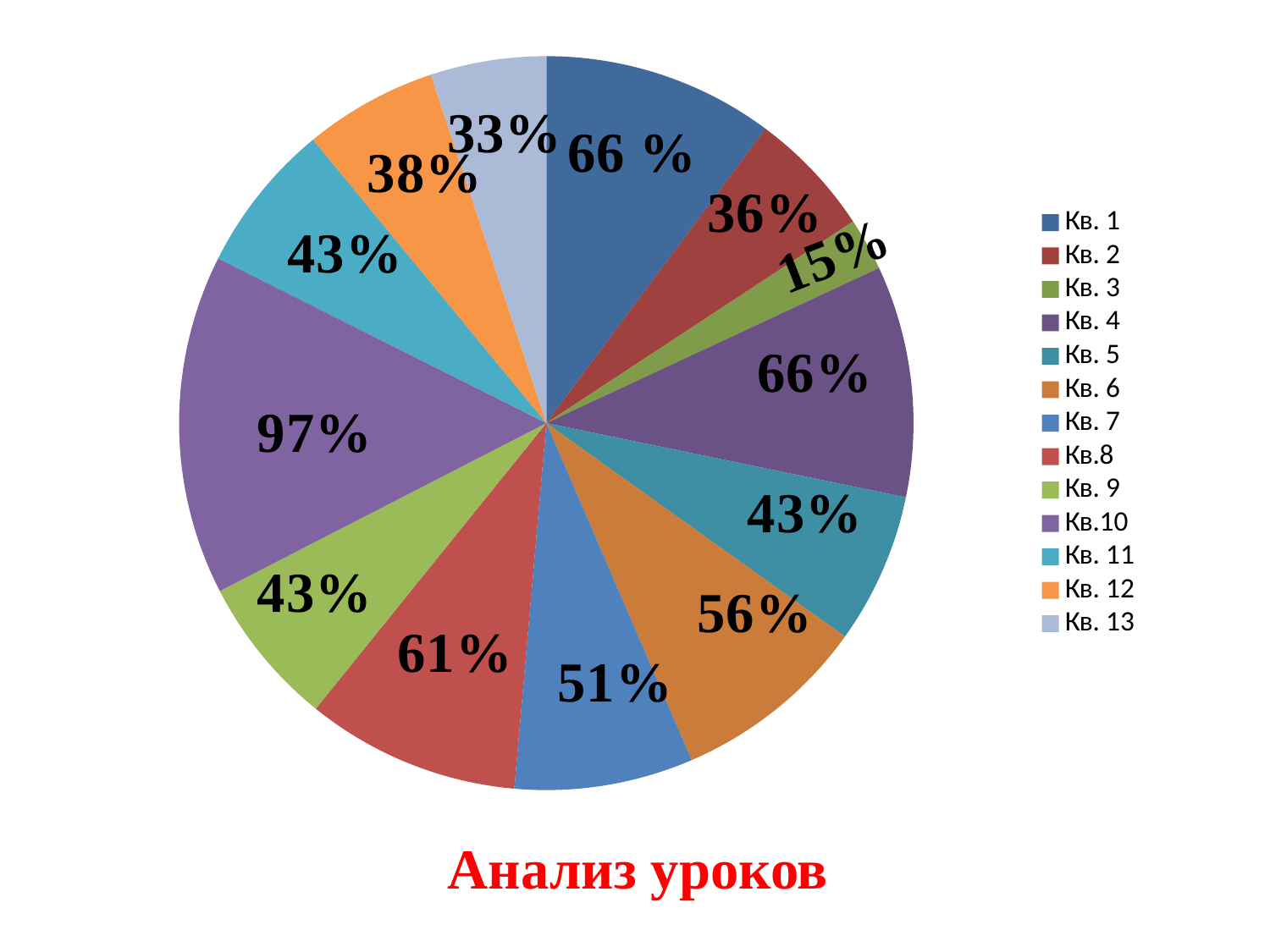
Which category has the lowest value? Кв. 3 What is the difference between the values for Кв.10 and Кв. 3? 82% What is the value shown for Кв. 1? 66 % What is the value shown for Кв. 3? 15% What type of chart is shown on the slide? pie chart How many slices does the pie chart have? 13 What is the value shown for Кв. 12? 38% What is the title shown below the chart? Анализ уроков What is the value shown for Кв.10? 97% Which is larger, the value for Кв. 6 or the value for Кв. 7? Кв. 6 What is the value shown for Кв.8? 61% Which category has the highest value? Кв.10